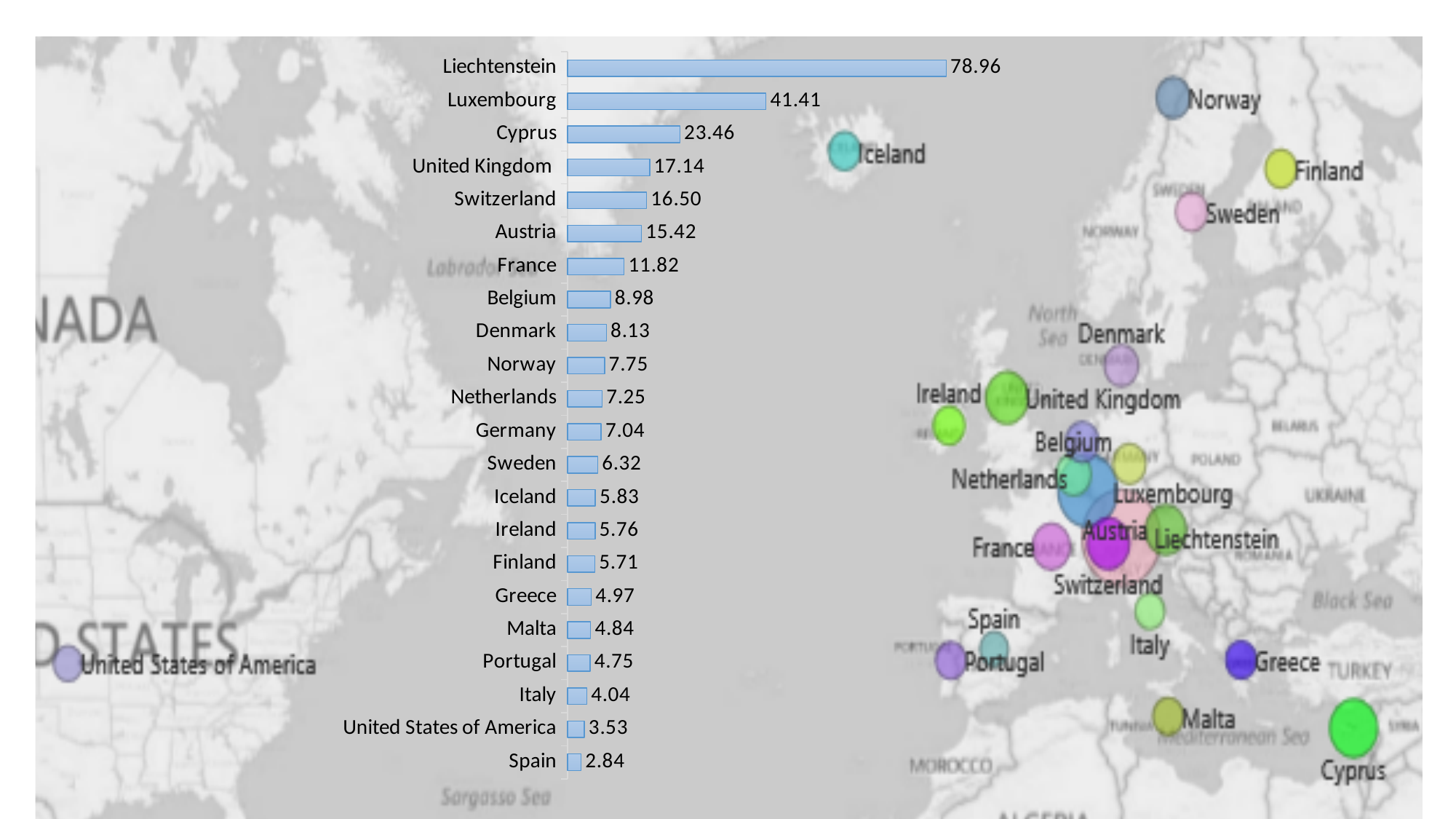
What is the difference between the values for Liechtenstein and Luxembourg? 37.55 What is the value for United States of America? 3.53 What is the value for Netherlands? 7.25 How many categories are shown in the bar chart? 22 Which category has the lowest value? Spain What is the value for United Kingdom? 17.14 Which has a larger value, Switzerland or Austria? Switzerland What is the value for Liechtenstein? 78.96 Which category has the highest value? Liechtenstein Which has a larger value, Italy or Portugal? Portugal What kind of chart is shown on the slide? Bar chart What is the difference between the values for Cyprus and United Kingdom? 6.32